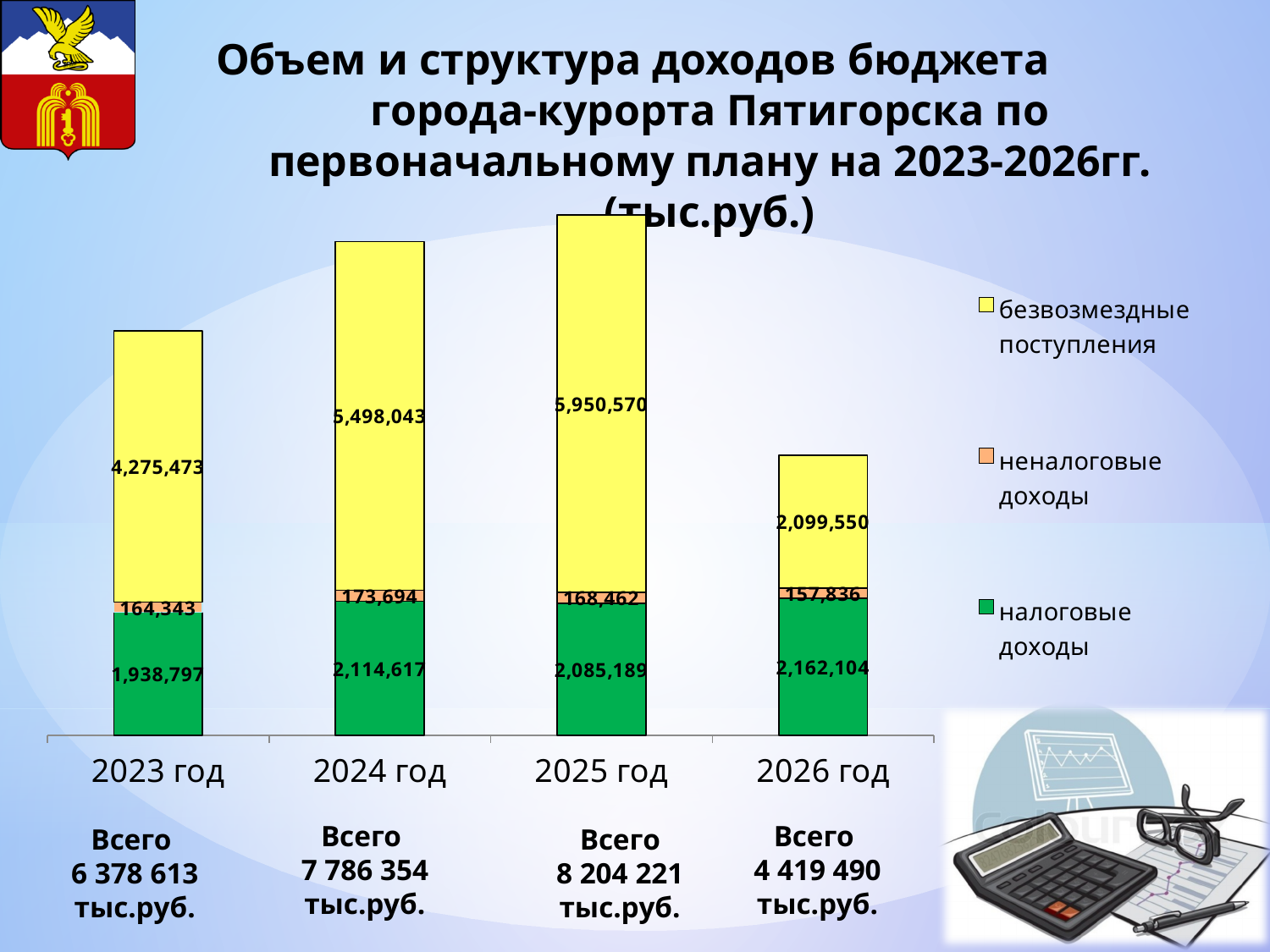
What type of chart is shown on the slide? Stacked bar chart What is the value of безвозмездные поступления for 2025 год? 5,950,570 Which series is shown in yellow in the legend? безвозмездные поступления In which year is the value of безвозмездные поступления the highest? 2025 год Which is larger: налоговые доходы in 2024 год or in 2025 год? 2024 год In which year is the value of безвозмездные поступления the lowest? 2026 год What is the value of налоговые доходы for 2026 год? 2,162,104 How many years (categories) are shown on the x axis? 4 What is the total of the stacked bar for 2024 год? 7 786 354 тыс.руб. What is the value of неналоговые доходы for 2023 год? 164,343 How many series does the legend list? 3 What is the difference between безвозмездные поступления in 2024 год and 2023 год? 1,222,570